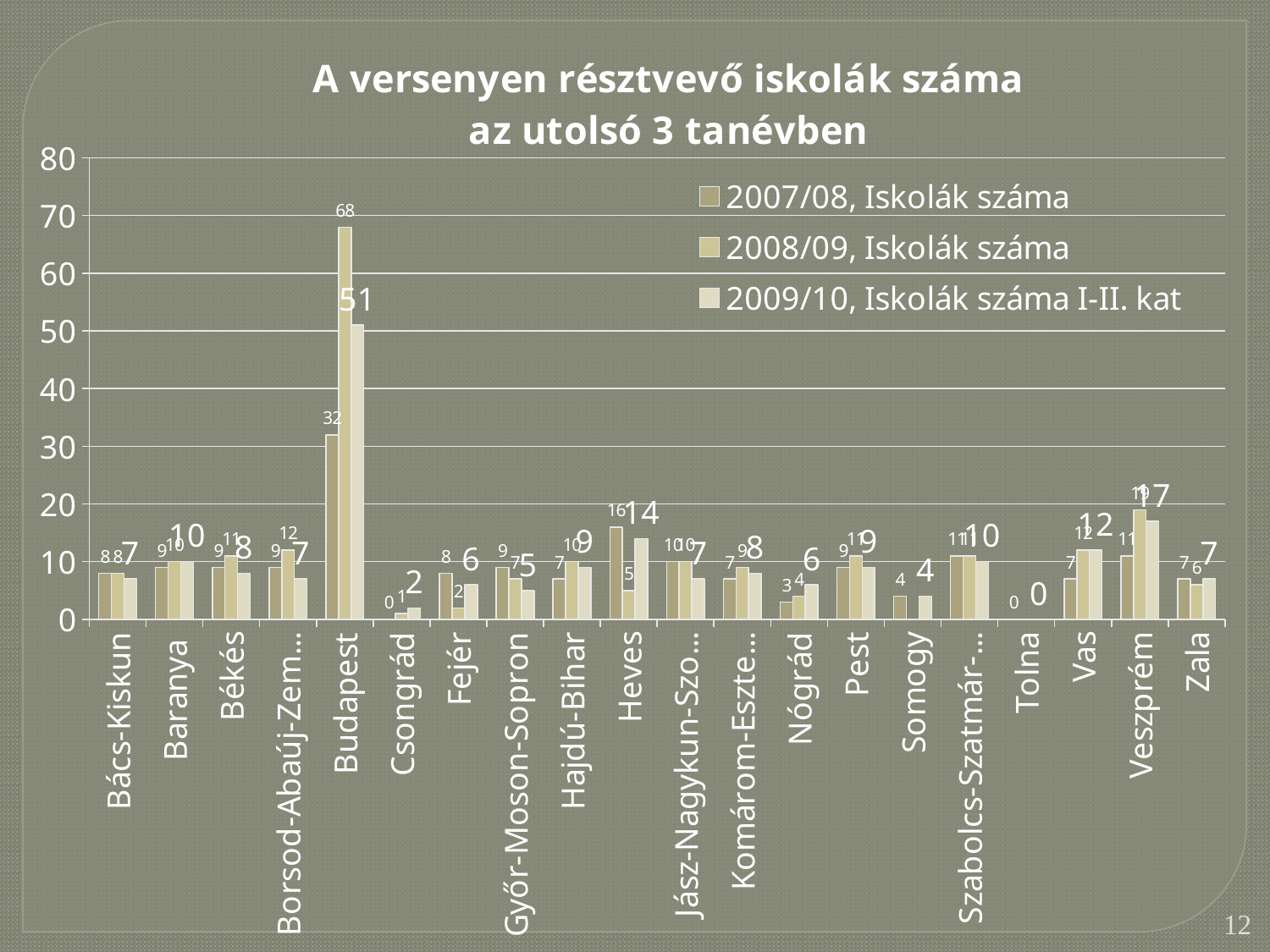
Which category has the highest value in the 2008/09 series? Budapest What is the value for Budapest in the 2007/08 series? 32 What is the value for Heves in the 2007/08 series? 16 What is the value for Veszprém in the 2009/10 series? 17 Which is larger for Heves: the 2007/08 value or the 2008/09 value? 2007/08 How many series does the legend list? 3 What kind of chart is shown on the slide? bar chart Is the value for Budapest in the 2008/09 series greater or less than 60? greater What is the value for Budapest in the 2008/09 series? 68 What is the value for Budapest in the 2009/10 series? 51 What is the difference between the 2008/09 and 2007/08 values for Budapest? 36 How many counties (categories) are shown on the x axis? 20